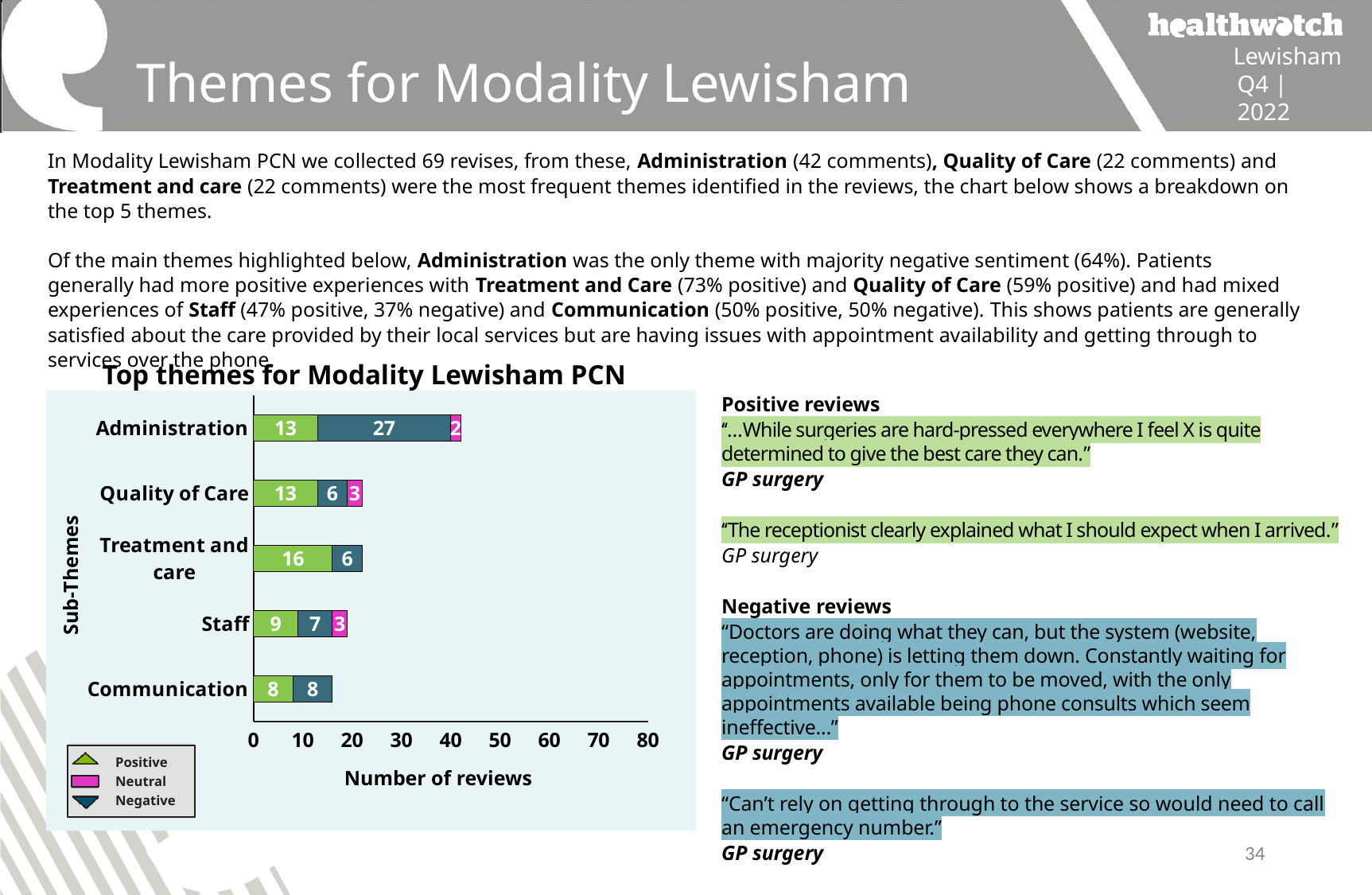
What is the number of negative reviews for Administration? 27 What is the number of positive reviews for Administration? 13 Which sub-theme has the highest total number of reviews? Administration What kind of chart is shown on the slide? Stacked bar chart How many series does the chart legend list? 3 What is the total number of reviews for Administration? 42 How many sub-themes are plotted in the chart? 5 Which sub-theme has the lowest total number of reviews? Communication What is the number of positive reviews for Treatment and care? 16 What is the total number of reviews for Staff? 19 What is the number of neutral reviews for Staff? 3 What is the difference between the negative and positive reviews for Administration? 14